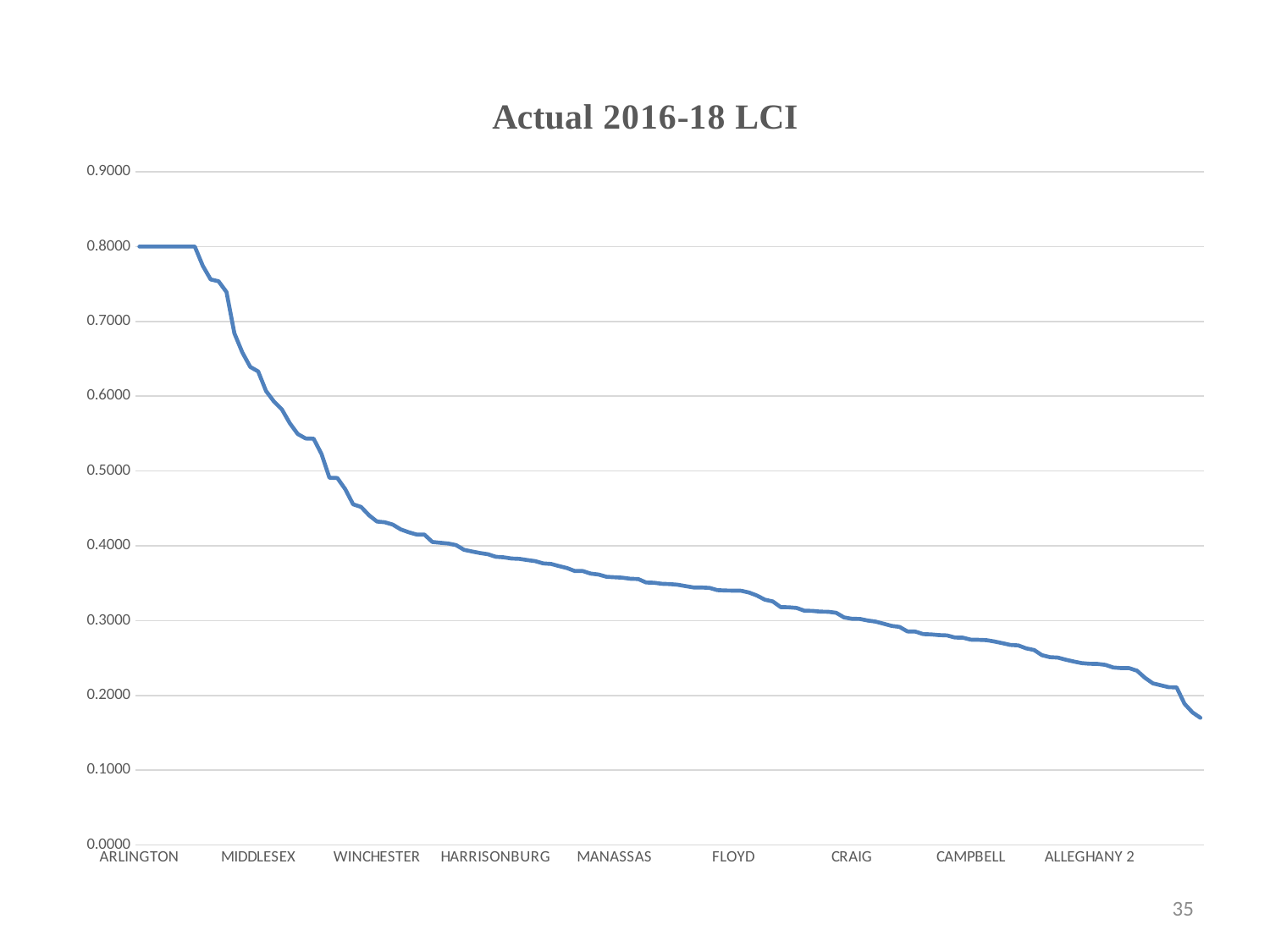
What kind of chart is shown on the slide? line chart What is the title of the chart? Actual 2016-18 LCI Which has the larger value, WINCHESTER or MANASSAS? WINCHESTER Do the values rise or fall moving from left to right along the x axis? fall How many category labels are shown on the x axis? 9 Which labelled category has the lowest value? ALLEGHANY 2 Is the value for WINCHESTER greater or less than 0.4000? greater What is the value for ARLINGTON? 0.8000 Is the value for MIDDLESEX greater or less than 0.7000? less Which labelled category has the highest value? ARLINGTON Is the value for ALLEGHANY 2 greater or less than 0.2000? greater